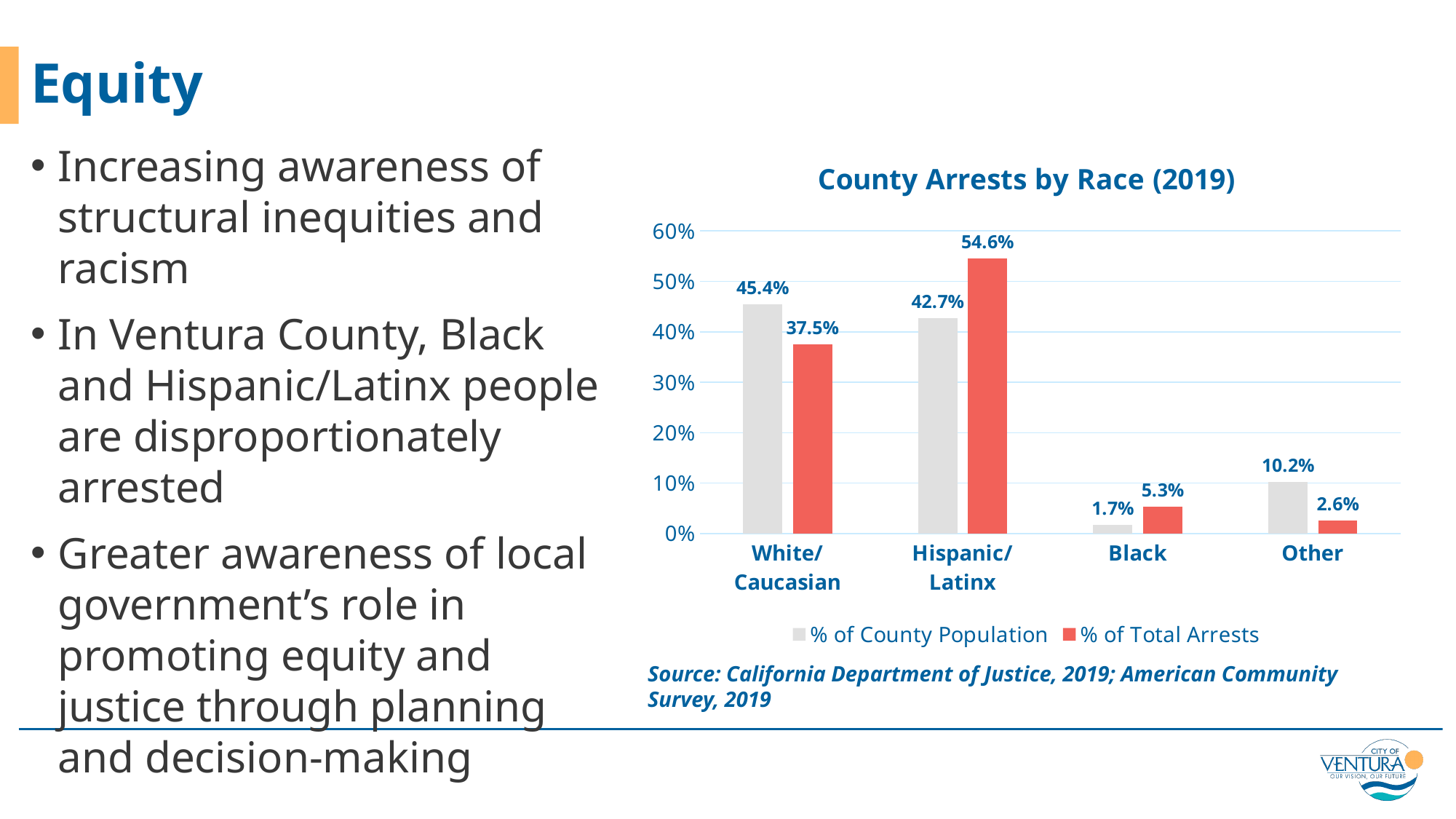
Which category has the highest % of Total Arrests? Hispanic/Latinx How many series does the legend list? 2 Which is larger for White/Caucasian: % of County Population or % of Total Arrests? % of County Population What is the % of County Population for White/Caucasian? 45.4% Which category has the lowest % of County Population? Black What is the difference between the % of Total Arrests and the % of County Population for Black? 3.6% What is the % of Total Arrests for Other? 2.6% What is the % of Total Arrests for Hispanic/Latinx? 54.6% What kind of chart is shown on the slide? Bar chart What is the title of the chart? County Arrests by Race (2019) How many race categories are shown on the x axis? 4 What is the % of County Population for Black? 1.7%